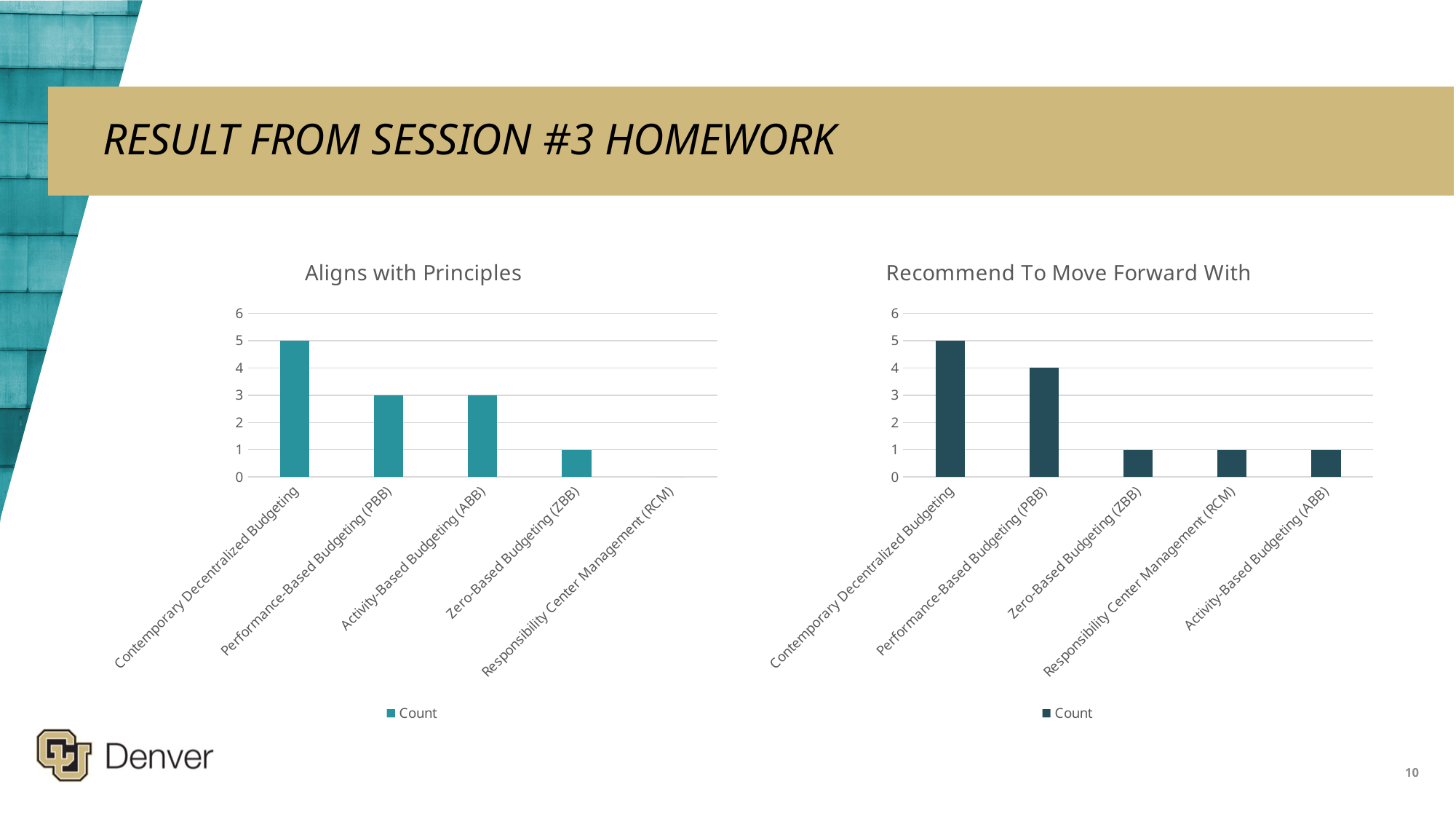
In the 'Aligns with Principles' chart, what is the difference between the counts for Contemporary Decentralized Budgeting and Performance-Based Budgeting (PBB)? 2 In the 'Recommend To Move Forward With' chart, what is the count for Activity-Based Budgeting (ABB)? 1 In the 'Aligns with Principles' chart, which category has the highest count? Contemporary Decentralized Budgeting How many series does the legend of the 'Recommend To Move Forward With' chart list? 1 In the 'Aligns with Principles' chart, which category has the lowest count? Responsibility Center Management (RCM) In the 'Recommend To Move Forward With' chart, which category has the highest count? Contemporary Decentralized Budgeting In the 'Recommend To Move Forward With' chart, what is the count for Performance-Based Budgeting (PBB)? 4 In the 'Aligns with Principles' chart, what is the count for Contemporary Decentralized Budgeting? 5 How many categories are shown on the x axis of the 'Recommend To Move Forward With' chart? 5 In the 'Aligns with Principles' chart, what is the count for Zero-Based Budgeting (ZBB)? 1 What kind of chart is the 'Aligns with Principles' chart? Bar chart In the 'Recommend To Move Forward With' chart, which is larger: the count for Performance-Based Budgeting (PBB) or Zero-Based Budgeting (ZBB)? Performance-Based Budgeting (PBB)